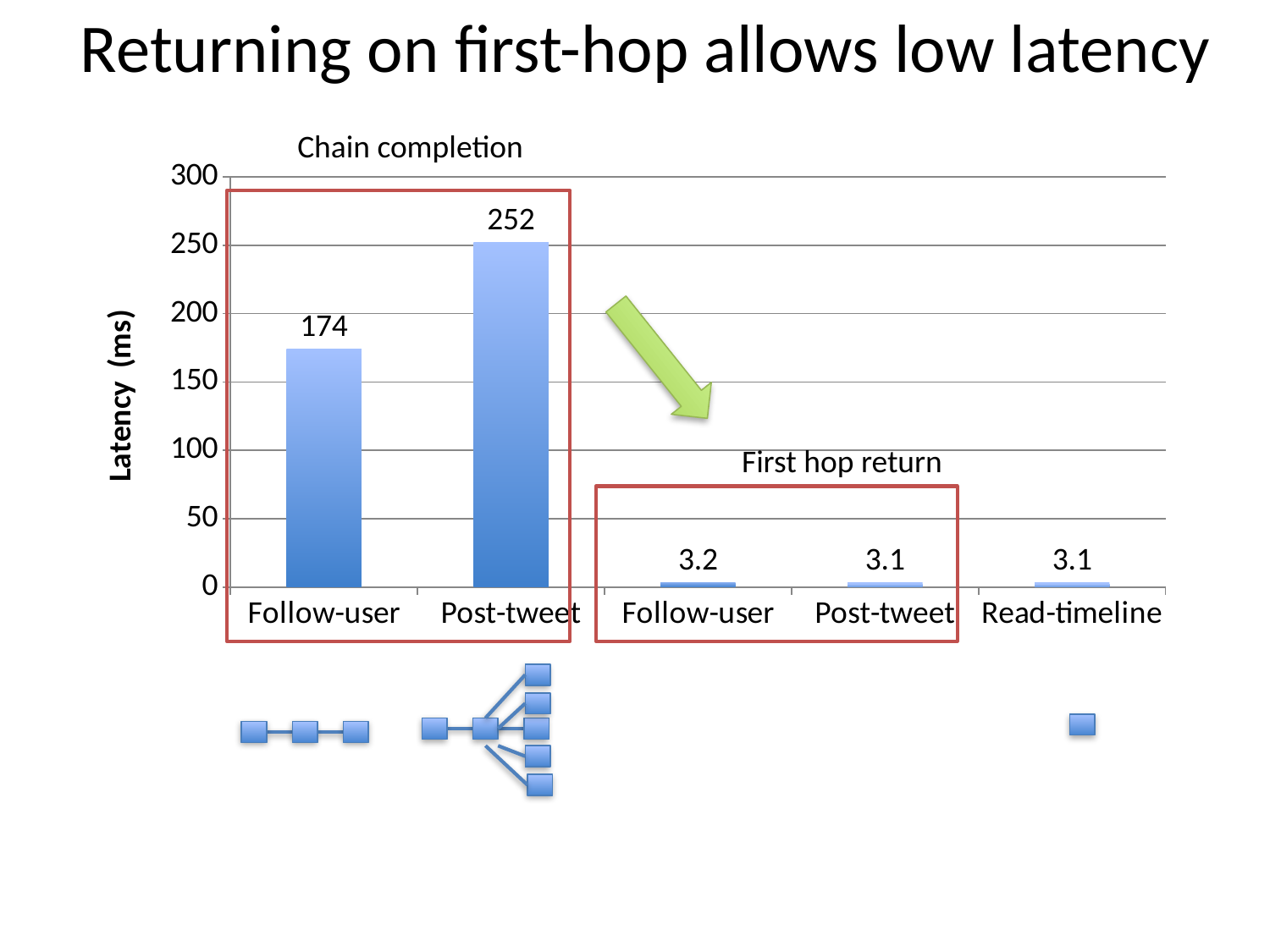
Is the Chain completion latency for Follow-user greater or less than 150? greater Which is larger: the Chain completion latency for Follow-user or for Post-tweet? Post-tweet What kind of chart is shown on the slide? bar chart What is the difference in latency between Follow-user and Post-tweet under First hop return? 0.1 What is the difference in latency between Post-tweet and Follow-user under Chain completion? 78 What is the latency for Post-tweet under Chain completion? 252 How many bars are plotted in the chart? 5 Which bar has the highest latency? Post-tweet (Chain completion) What is the latency for Follow-user under First hop return? 3.2 What is the latency for Follow-user under Chain completion? 174 What is the latency for Read-timeline? 3.1 What is the label of the y axis? Latency (ms)